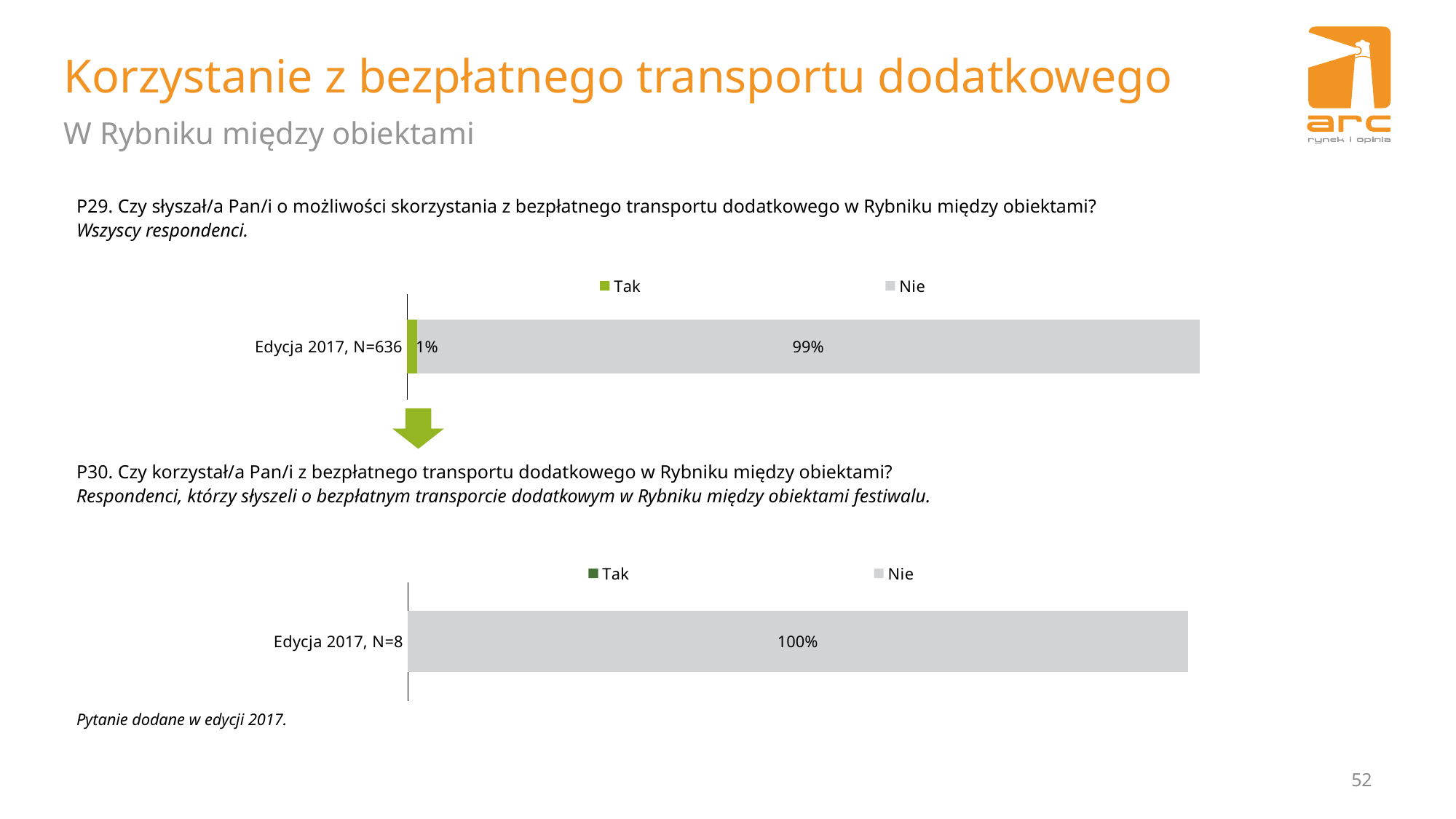
How many categories (bars) are shown in the P30 chart (bottom)? 1 In the P29 chart (top), what is the total of the stacked bar for Edycja 2017, N=636? 100% In the P29 chart (top), which colour represents the "Tak" series? Green In the P29 chart (top), what percentage of respondents answered "Tak" for Edycja 2017, N=636? 1% In the P29 chart (top), which answer has the larger share, "Tak" or "Nie"? Nie In the P30 chart (bottom), what percentage of respondents answered "Nie" for Edycja 2017, N=8? 100% What is the category label of the bar in the P30 chart (bottom)? Edycja 2017, N=8 How many series does the legend of the P29 chart (top) list? 2 What kind of chart is the P29 chart (top)? Stacked bar chart In the P29 chart (top), what percentage of respondents answered "Nie" for Edycja 2017, N=636? 99% How many series does the legend of the P30 chart (bottom) list? 2 In the P29 chart (top), what is the difference in percentage points between "Nie" and "Tak"? 98